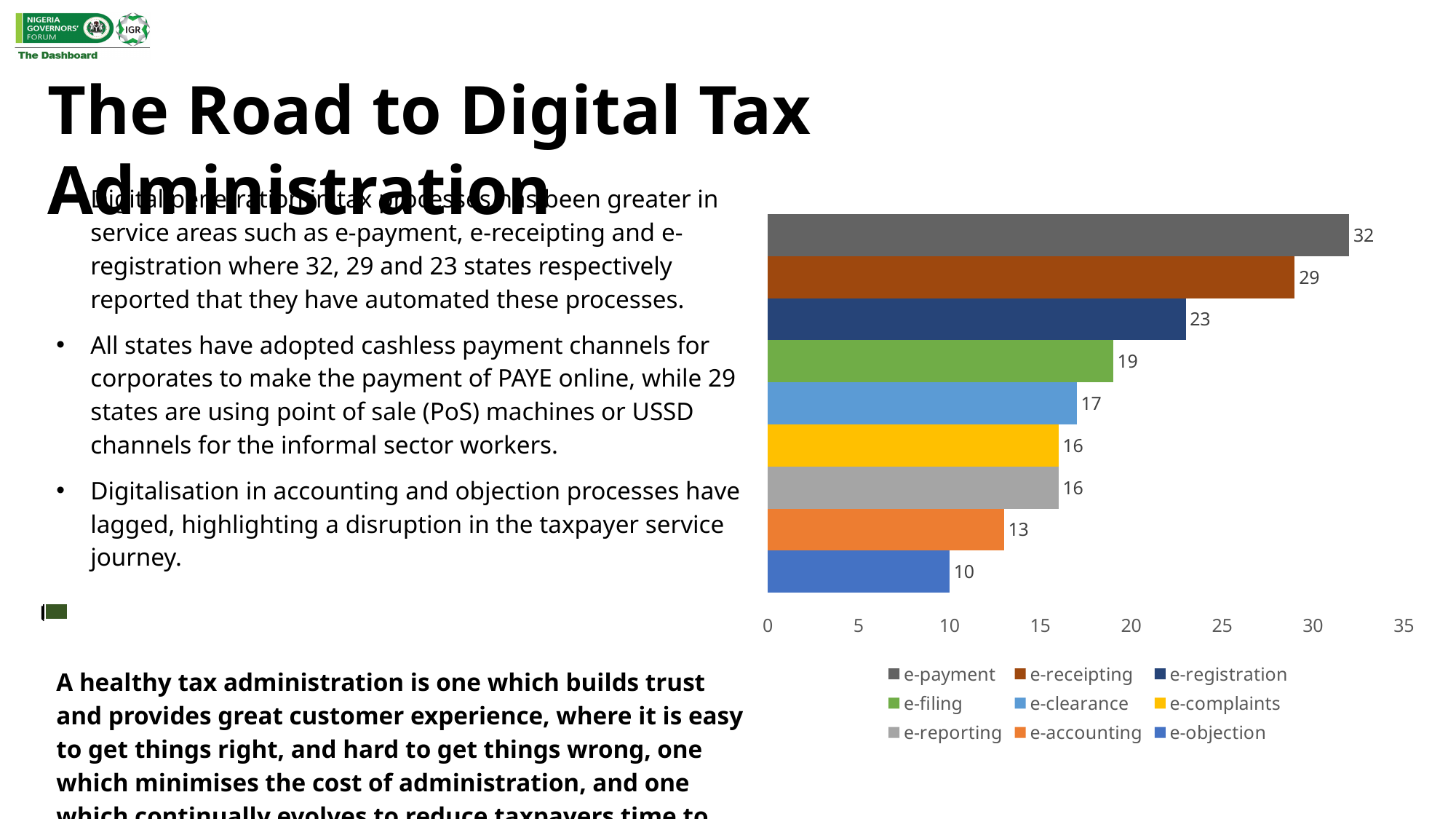
What kind of chart is shown on the slide? bar chart Which series has the lowest value? e-objection How many series does the legend list? 9 What value is shown for e-registration? 23 What value is shown for e-accounting? 13 Which is larger, the value for e-clearance or the value for e-accounting? e-clearance What value is shown for e-payment? 32 What is the difference between the values for e-filing and e-objection? 9 Which series has the highest value? e-payment Is the value for e-receipting greater or less than 25? greater How many bars are plotted in the chart? 9 What is the difference between the values for e-payment and e-receipting? 3